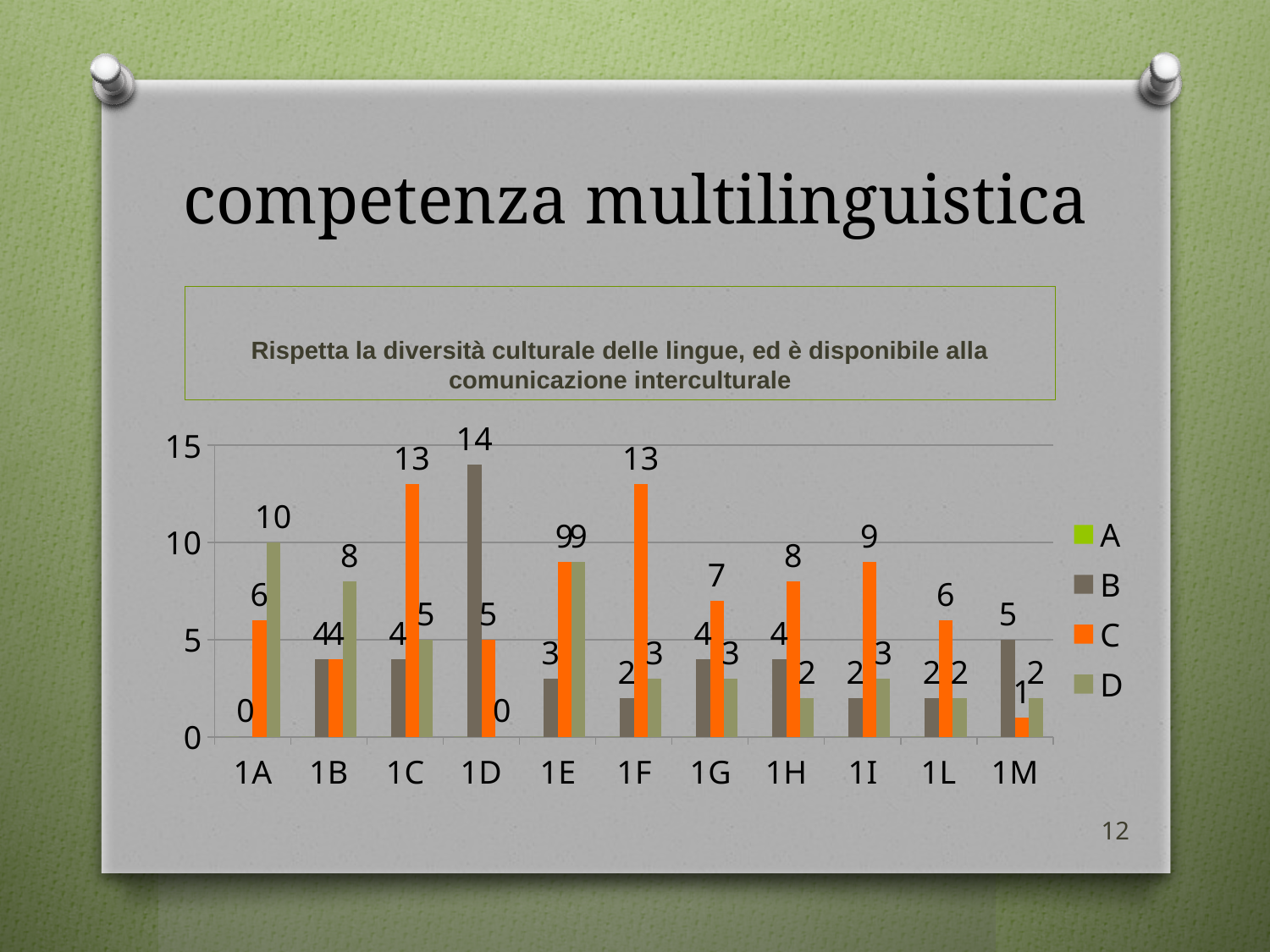
What is the difference between series C and series B for category 1C? 9 What type of chart is shown on the slide? bar chart How many series does the legend list? 4 What is the value of series C for category 1M? 1 Which category has the highest value for series B? 1D What is the value of series B for category 1D? 14 What is the value of series D for category 1A? 10 What is the value of series C for category 1C? 13 Which is larger: series D for 1A or series D for 1B? 1A Which category has the lowest value for series C? 1M Which category has the highest value for series D? 1A How many categories are shown on the x axis? 11